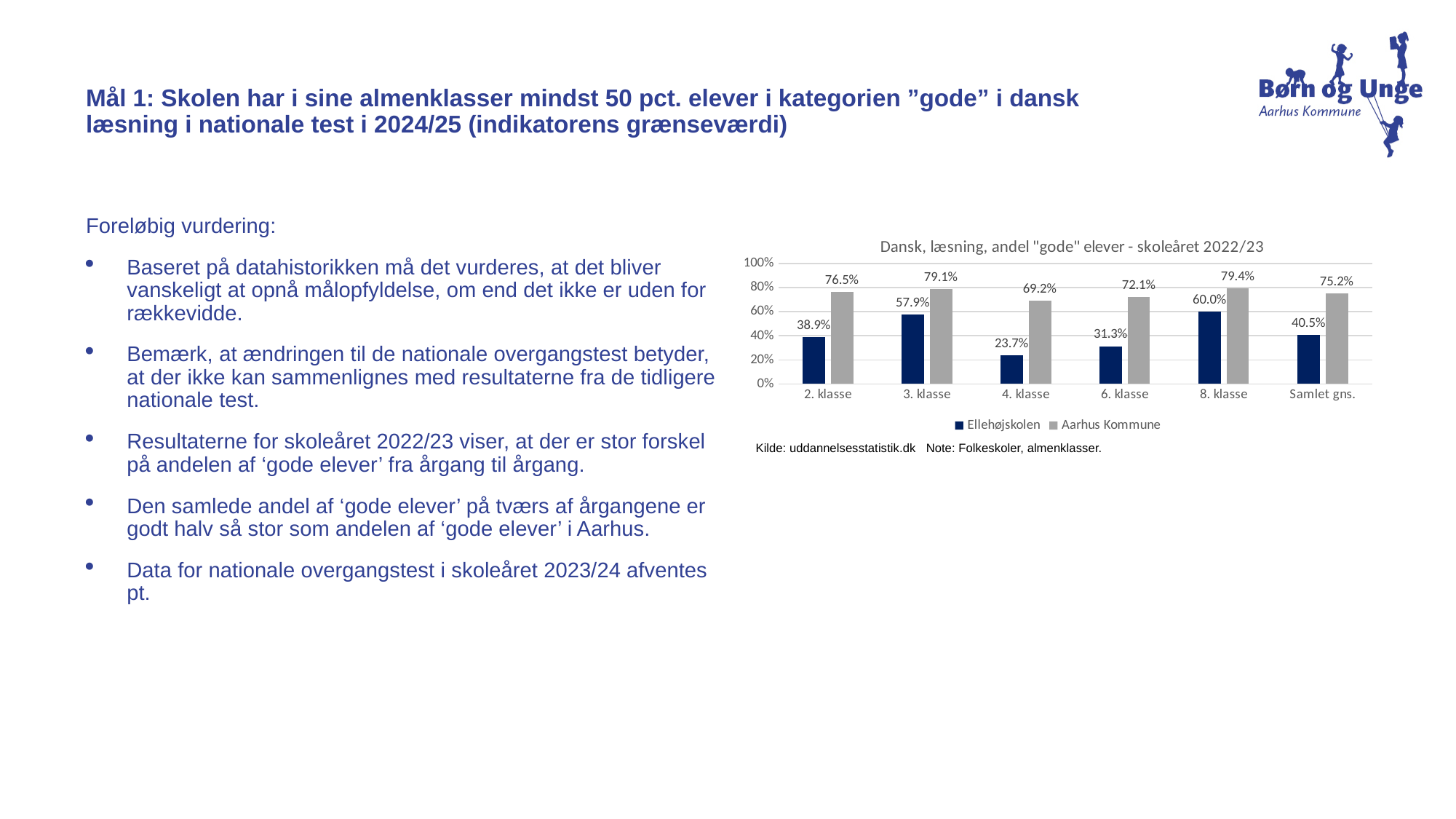
What is the value for Ellehøjskolen in 3. klasse? 57.9% How many categories are shown on the x axis? 6 Which category has the lowest value for Ellehøjskolen? 4. klasse What is the difference between Aarhus Kommune and Ellehøjskolen in 4. klasse? 45.5% What kind of chart is shown on the slide? Bar chart Which category has the highest value for Ellehøjskolen? 8. klasse How many series does the legend list? 2 What is the title of the chart? Dansk, læsning, andel "gode" elever - skoleåret 2022/23 Which category has the highest value for Aarhus Kommune? 8. klasse Which is larger in 2. klasse: Ellehøjskolen or Aarhus Kommune? Aarhus Kommune What is the value for Aarhus Kommune in 6. klasse? 72.1% What is the value for Ellehøjskolen for Samlet gns.? 40.5%